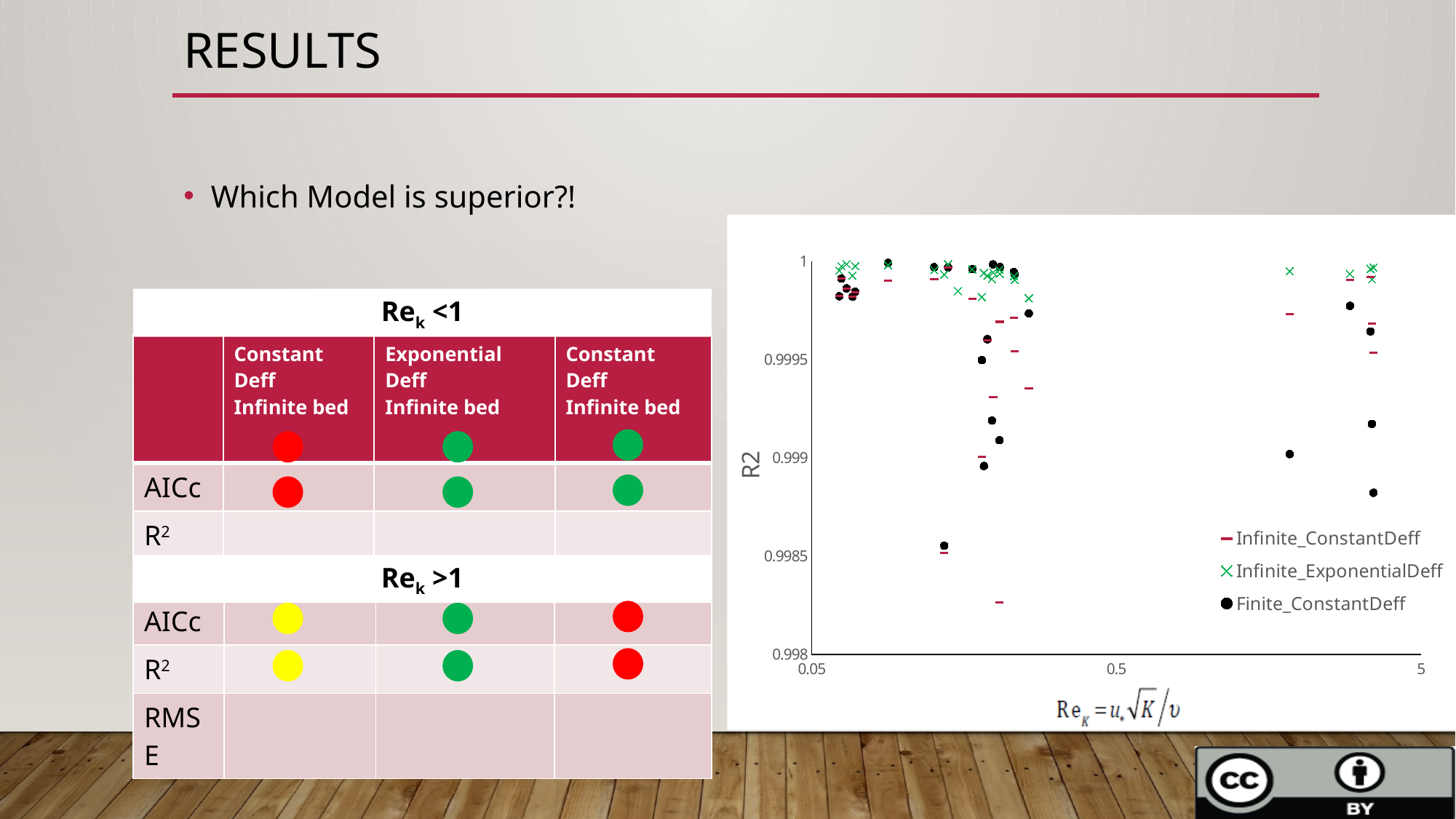
Is the lowest plotted value for the Finite_ConstantDeff series greater or less than 0.999? less What kind of chart is shown on the slide? scatter chart Which series is plotted with green x markers? Infinite_ExponentialDeff How many series does the chart legend list? 3 Which series has the lowest point: Infinite_ExponentialDeff or Finite_ConstantDeff? Finite_ConstantDeff What is the label on the y axis of the chart? R2 Are all plotted values for the Infinite_ExponentialDeff series greater or less than 0.9995? greater Is the lowest plotted value for the Infinite_ConstantDeff series greater or less than 0.9985? less What is the lowest value shown on the y axis of the chart? 0.998 Which series contains the lowest R2 value on the chart? Infinite_ConstantDeff